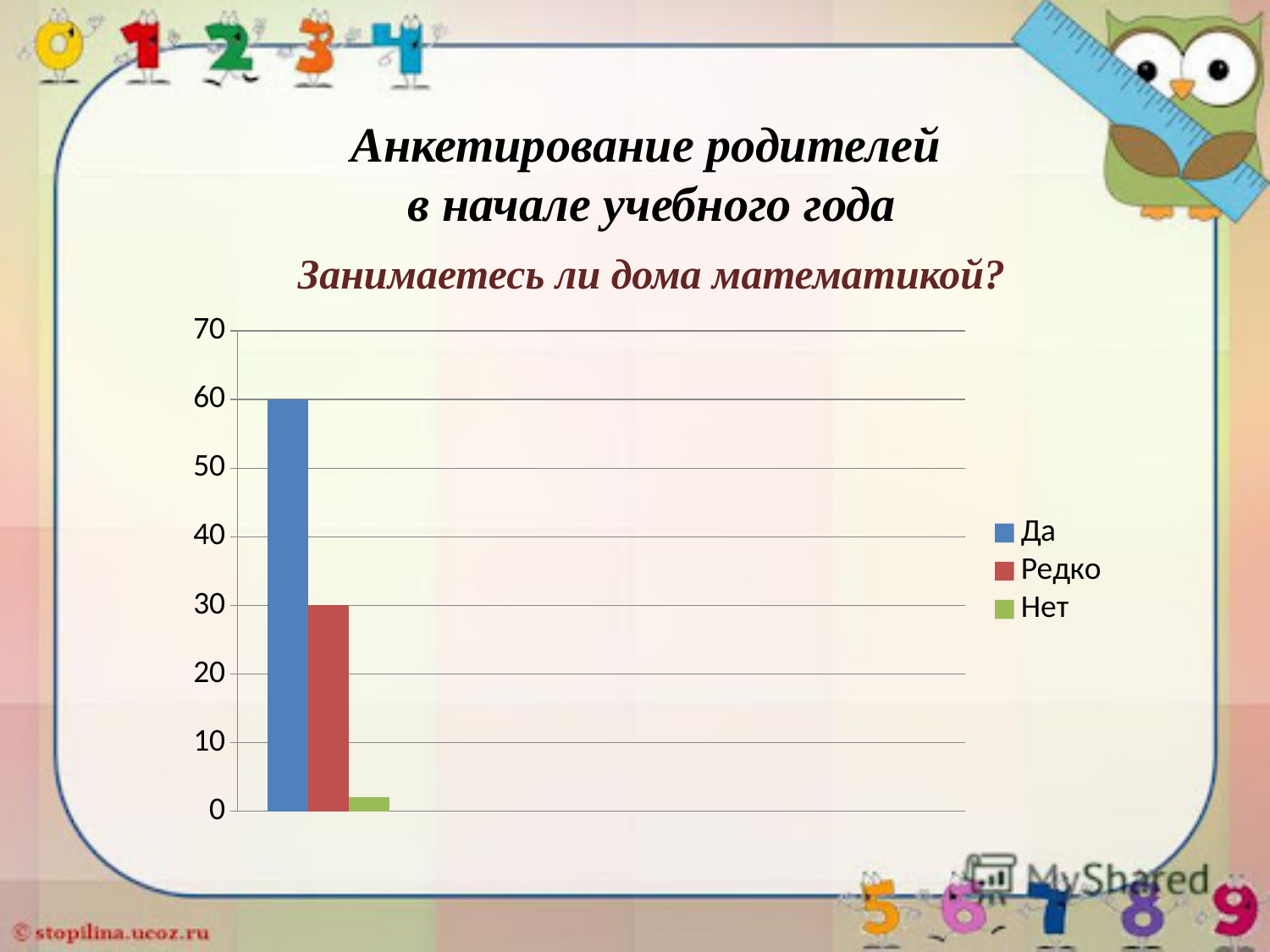
What is the value for Редко? 30 What is the question shown as the chart's title? Занимаетесь ли дома математикой? How many series does the legend list? 3 What colour is the bar for Редко? red Which series has the highest value? Да Which is larger, the value for Да or the value for Редко? Да Is the value for Да greater or less than 50? greater What is the value for Да? 60 What is the difference between the values for Да and Редко? 30 Which series has the lowest value? Нет Is the value for Нет greater or less than 10? less What kind of chart is shown on the slide? bar chart